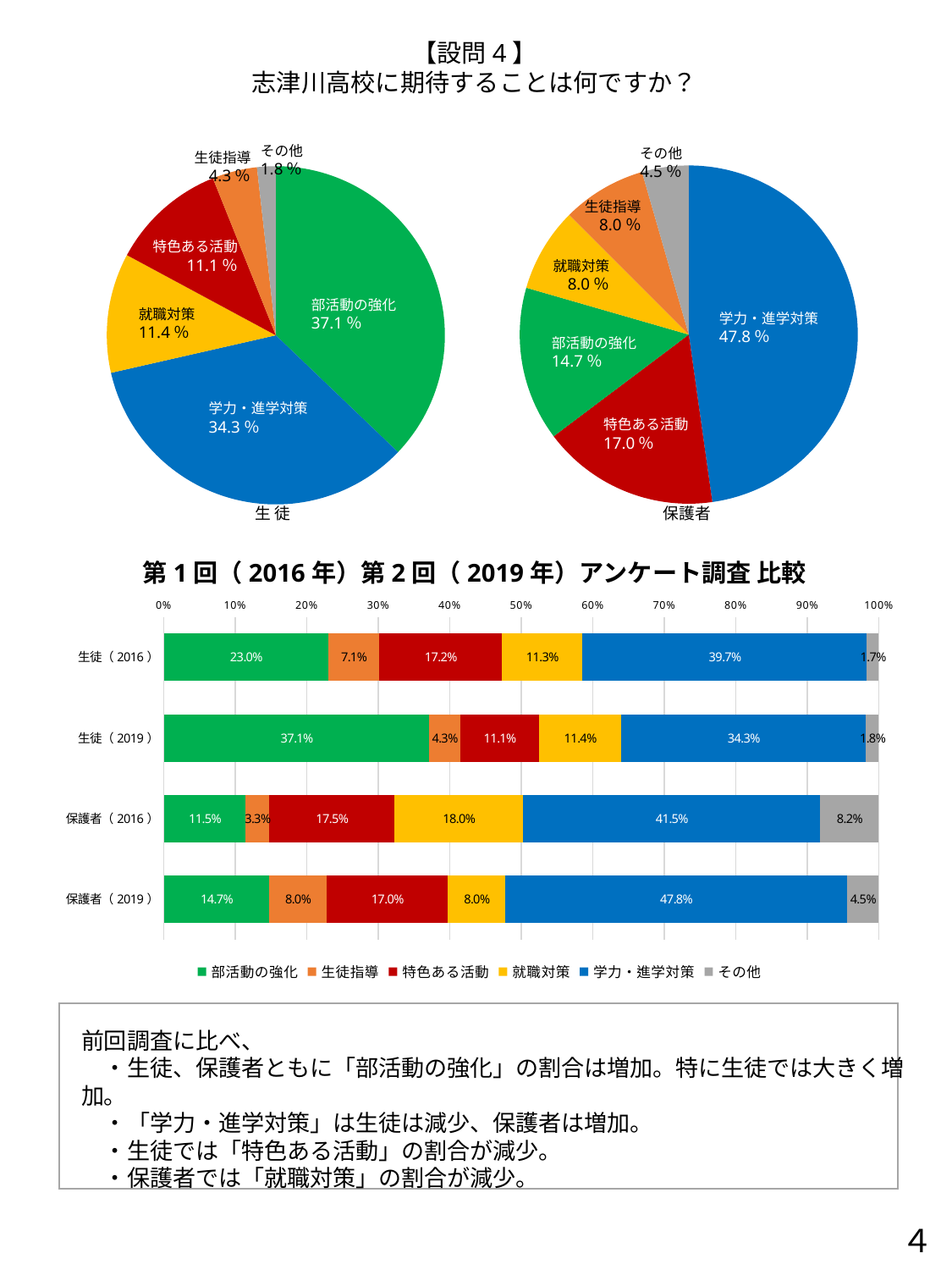
In the bottom comparison chart, how many series does the legend list? 6 In the bottom comparison chart, which is larger for 保護者: 就職対策 in 2016 or in 2019? 2016 In the 生徒 pie chart, which category has the smallest slice? その他 What type of chart is the bottom comparison chart? Stacked bar chart In the 生徒 pie chart, which is larger: 就職対策 or 生徒指導? 就職対策 What type of chart is used for the 生徒 and 保護者 charts at the top of the slide? Pie chart In the bottom comparison chart, how many bars (rows) are shown? 4 In the 保護者 pie chart, what is the difference between 学力・進学対策 and 部活動の強化? 33.1 % In the 生徒 pie chart, what share does 部活動の強化 have? 37.1 % In the bottom comparison chart, what is the difference in 部活動の強化 between 生徒（2019）and 生徒（2016）? 14.1% In the bottom chart (第1回（2016年）第2回（2019年）アンケート調査 比較), what is the value of 学力・進学対策 for 生徒（2016）? 39.7% In the 保護者 pie chart, which category has the largest slice? 学力・進学対策